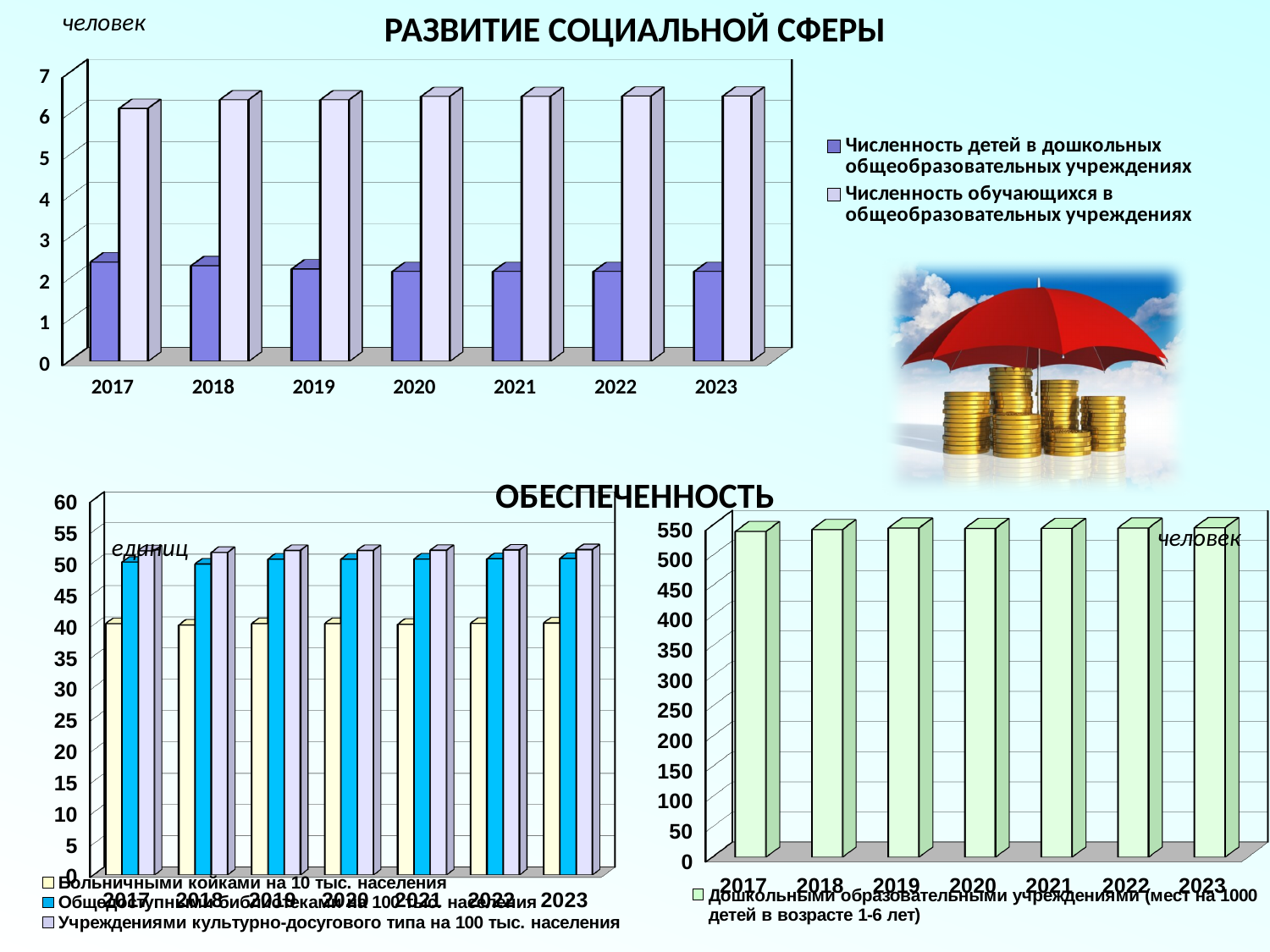
In the top chart 'РАЗВИТИЕ СОЦИАЛЬНОЙ СФЕРЫ', how many years are shown on the x axis? 7 In the bottom-left chart, how many series does the legend list? 3 In the top chart 'РАЗВИТИЕ СОЦИАЛЬНОЙ СФЕРЫ', is the value for 'Численность обучающихся в общеобразовательных учреждениях' in 2017 greater or less than 5? greater In the top chart 'РАЗВИТИЕ СОЦИАЛЬНОЙ СФЕРЫ', does the series 'Численность детей в дошкольных общеобразовательных учреждениях' rise or fall from 2017 to 2023? fall In the top chart 'РАЗВИТИЕ СОЦИАЛЬНОЙ СФЕРЫ', which series has the larger value in 2020? Численность обучающихся в общеобразовательных учреждениях What kind of chart is the top chart titled 'РАЗВИТИЕ СОЦИАЛЬНОЙ СФЕРЫ'? bar chart In the bottom-right chart, how many years are shown on the x axis? 7 In the top chart 'РАЗВИТИЕ СОЦИАЛЬНОЙ СФЕРЫ', is the value for 'Численность детей в дошкольных общеобразовательных учреждениях' in 2023 greater or less than 3? less In the top chart 'РАЗВИТИЕ СОЦИАЛЬНОЙ СФЕРЫ', how many series does the legend list? 2 In the bottom-left chart, is the value for 'Больничными койками на 10 тыс. населения' in 2017 greater or less than 45? less In the bottom-left chart, which is larger in 2019: 'Общедоступными библиотеками на 100 тыс. населения' or 'Больничными койками на 10 тыс. населения'? Общедоступными библиотеками на 100 тыс. населения